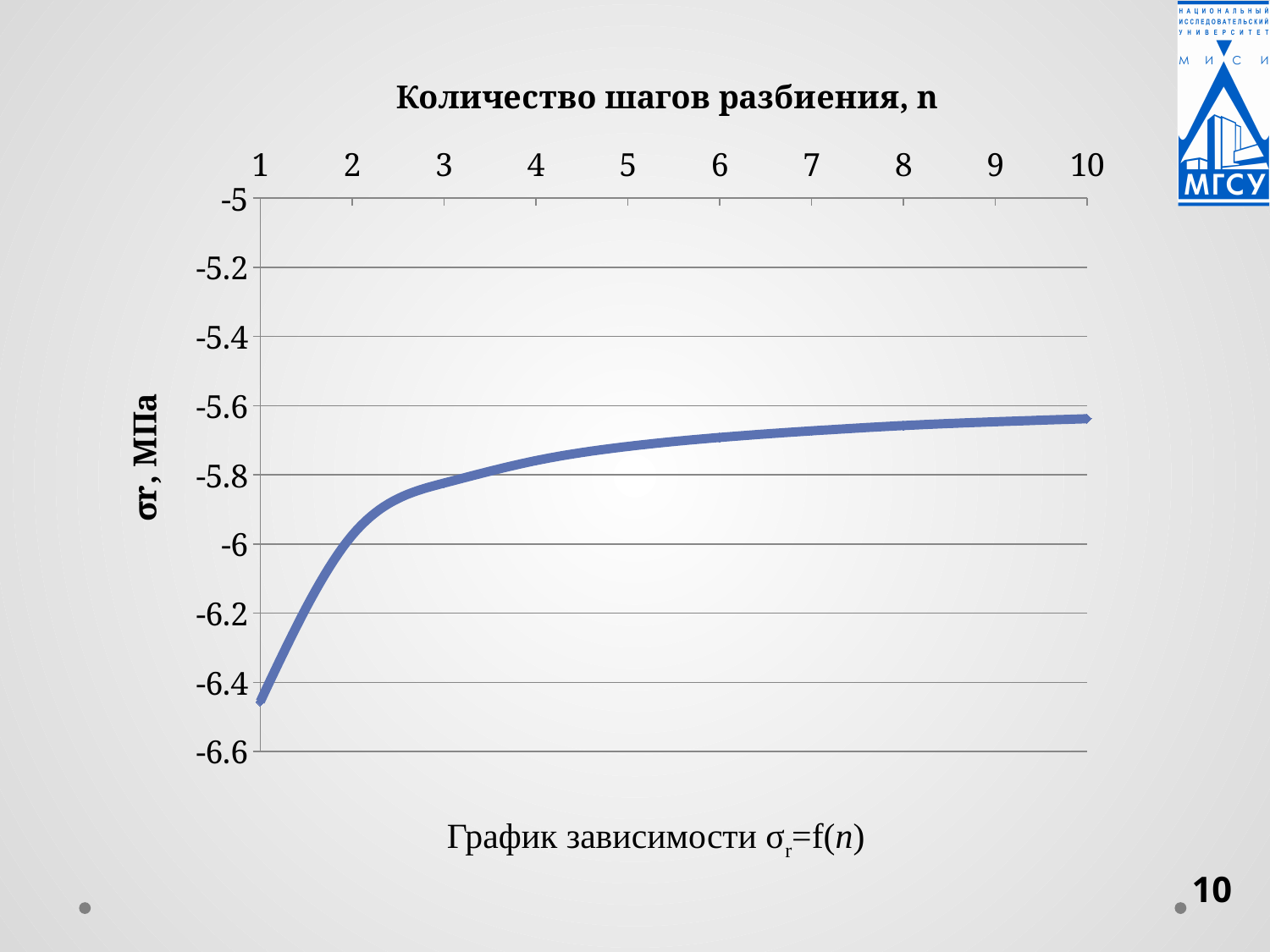
How many values of n are marked on the horizontal axis? 10 Is the value of σr at n = 10 greater or less than -5.8? greater Is the value of σr at n = 2 greater or less than -5.8? less At which value of n is σr lowest? 1 Is the value of σr at n = 1 greater or less than -6.2? less At which value of n is σr highest? 10 What is the title of the chart? Количество шагов разбиения, n Which is larger, the value of σr at n = 3 or at n = 8? n = 8 Does the value of σr rise or fall as n increases from 1 to 10? rise What kind of chart is shown on the slide? line chart What is the label of the vertical axis? σr, МПа